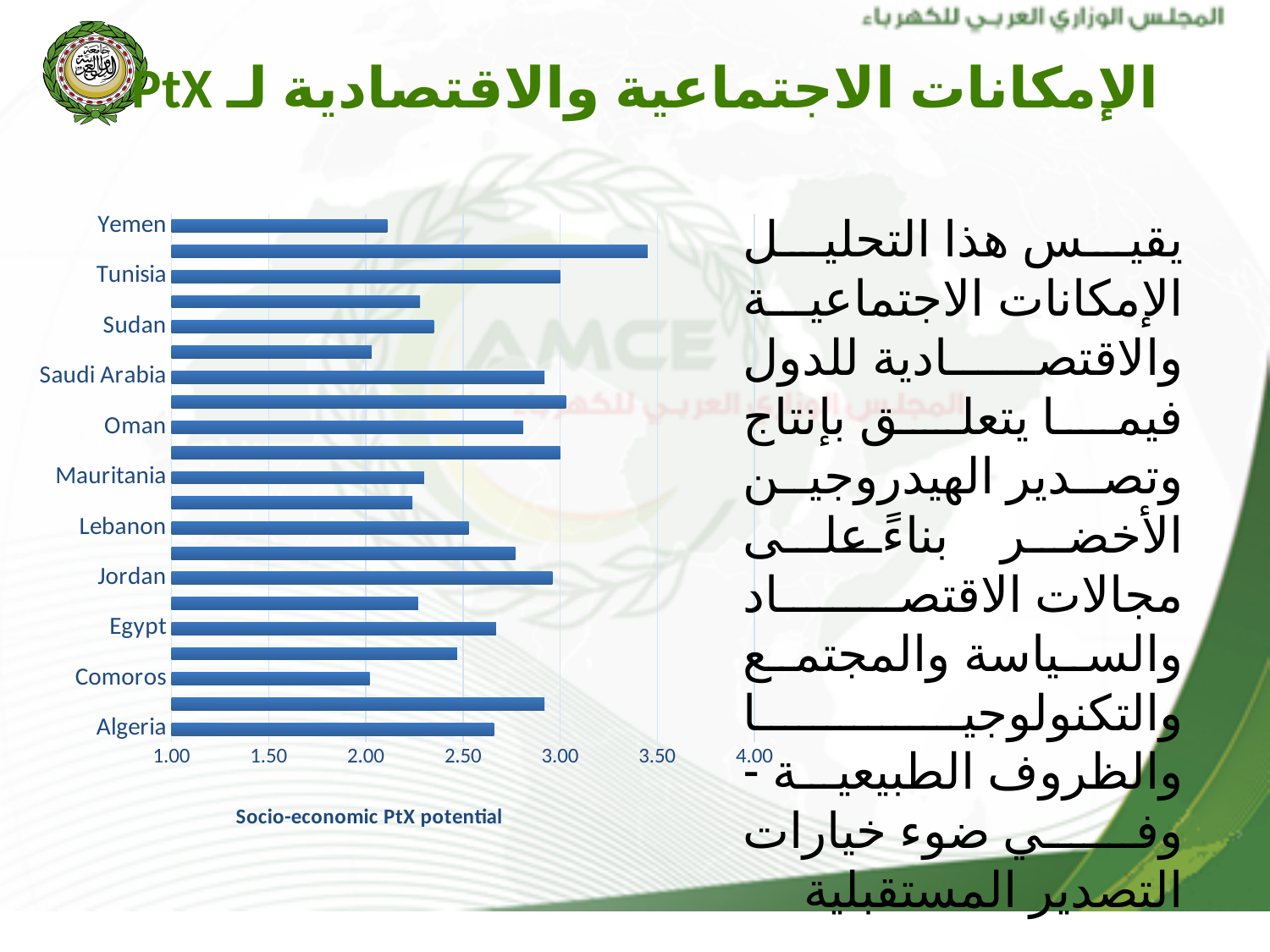
Which has the larger value, Tunisia or Yemen? Tunisia What is the title of the chart? Socio-economic PtX potential How many country names are labelled on the vertical axis of the chart? 11 What kind of chart is shown on the slide? bar chart Is the value for Tunisia greater or less than 2.50? greater Is the value for Saudi Arabia greater or less than 2.50? greater Is the value for Jordan greater or less than 2.50? greater Which has the larger value, Comoros or Saudi Arabia? Saudi Arabia Which has the larger value, Oman or Mauritania? Oman